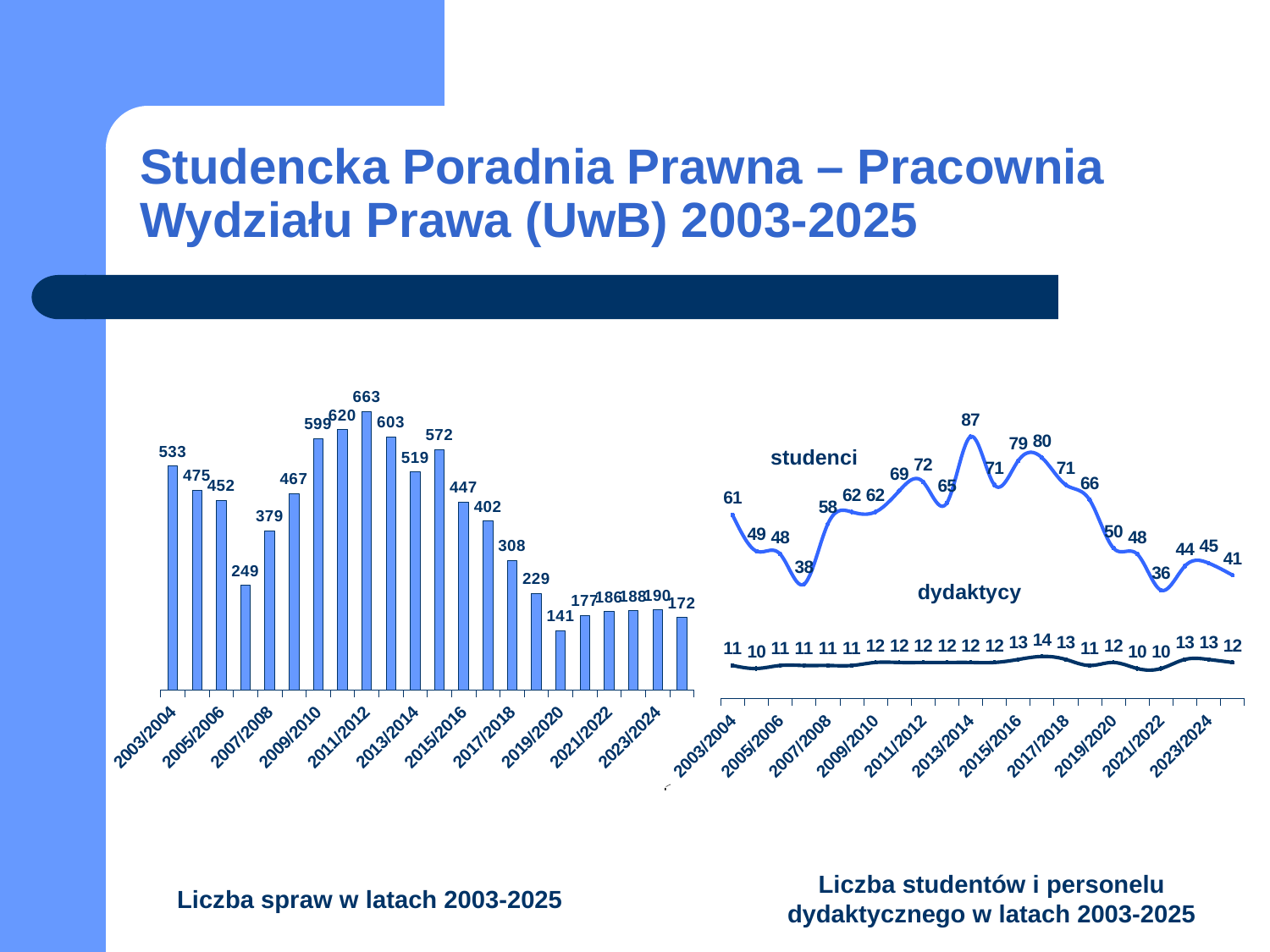
In the left chart 'Liczba spraw w latach 2003-2025', what is the highest value shown? 663 What kind of chart is the left chart, 'Liczba spraw w latach 2003-2025'? bar chart How many series are shown in the right chart 'Liczba studentów i personelu dydaktycznego w latach 2003-2025'? 2 In the left chart 'Liczba spraw w latach 2003-2025', do the values rise or fall from 2011/2012 to 2019/2020? fall In the right chart 'Liczba studentów i personelu dydaktycznego w latach 2003-2025', which series has the larger value in 2013/2014, 'studenci' or 'dydaktycy'? studenci In the left chart 'Liczba spraw w latach 2003-2025', which year has the lowest number of cases? 2019/2020 In the right chart 'Liczba studentów i personelu dydaktycznego w latach 2003-2025', what is the value of 'studenci' for 2003/2004? 61 In the left chart 'Liczba spraw w latach 2003-2025', what is the value for 2003/2004? 533 In the right chart 'Liczba studentów i personelu dydaktycznego w latach 2003-2025', what is the highest value of the 'studenci' series? 87 In the left chart 'Liczba spraw w latach 2003-2025', which year has the highest number of cases? 2011/2012 How many bars are plotted in the left chart 'Liczba spraw w latach 2003-2025'? 22 In the left chart 'Liczba spraw w latach 2003-2025', what is the difference between the highest value (663) and the lowest value (141)? 522